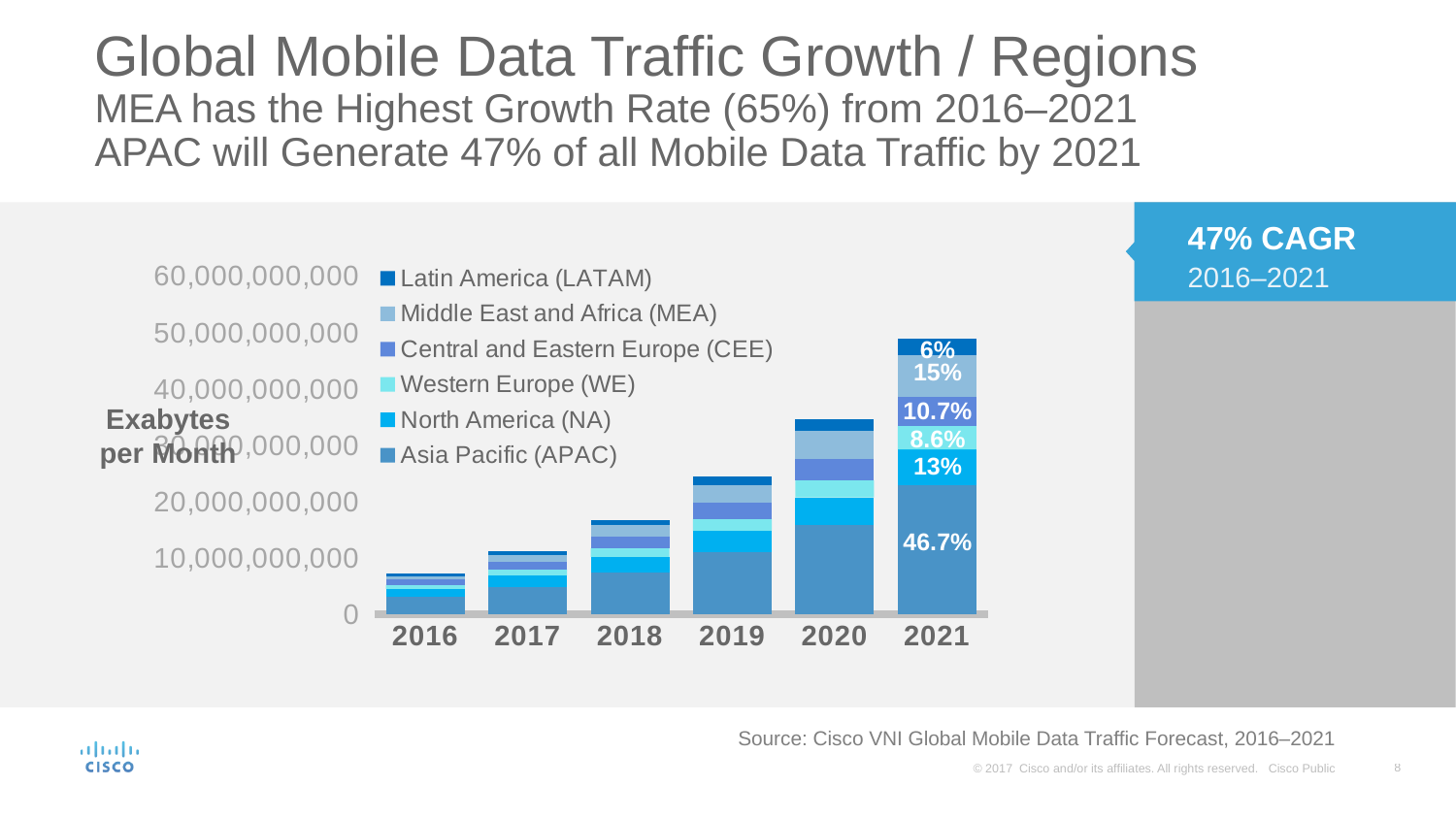
In the 2021 bar, what is the difference between the Asia Pacific (APAC) label and the North America (NA) label? 33.7% How many years are shown along the x axis of the chart? 6 Which year has the shortest bar? 2016 What kind of chart is shown on the slide? Stacked bar chart Is the total bar for 2018 greater or less than 20,000,000,000? less What percentage is labelled for Western Europe (WE) in the 2021 bar? 8.6% Which year has the tallest bar? 2021 Is the total bar for 2021 greater or less than 40,000,000,000? greater What share of mobile data traffic is labelled for Asia Pacific (APAC) in the 2021 bar? 46.7% What percentage is labelled for Middle East and Africa (MEA) in the 2021 bar? 15% How many series does the chart's legend list? 6 Do the total bar heights rise or fall from 2016 to 2021? Rise